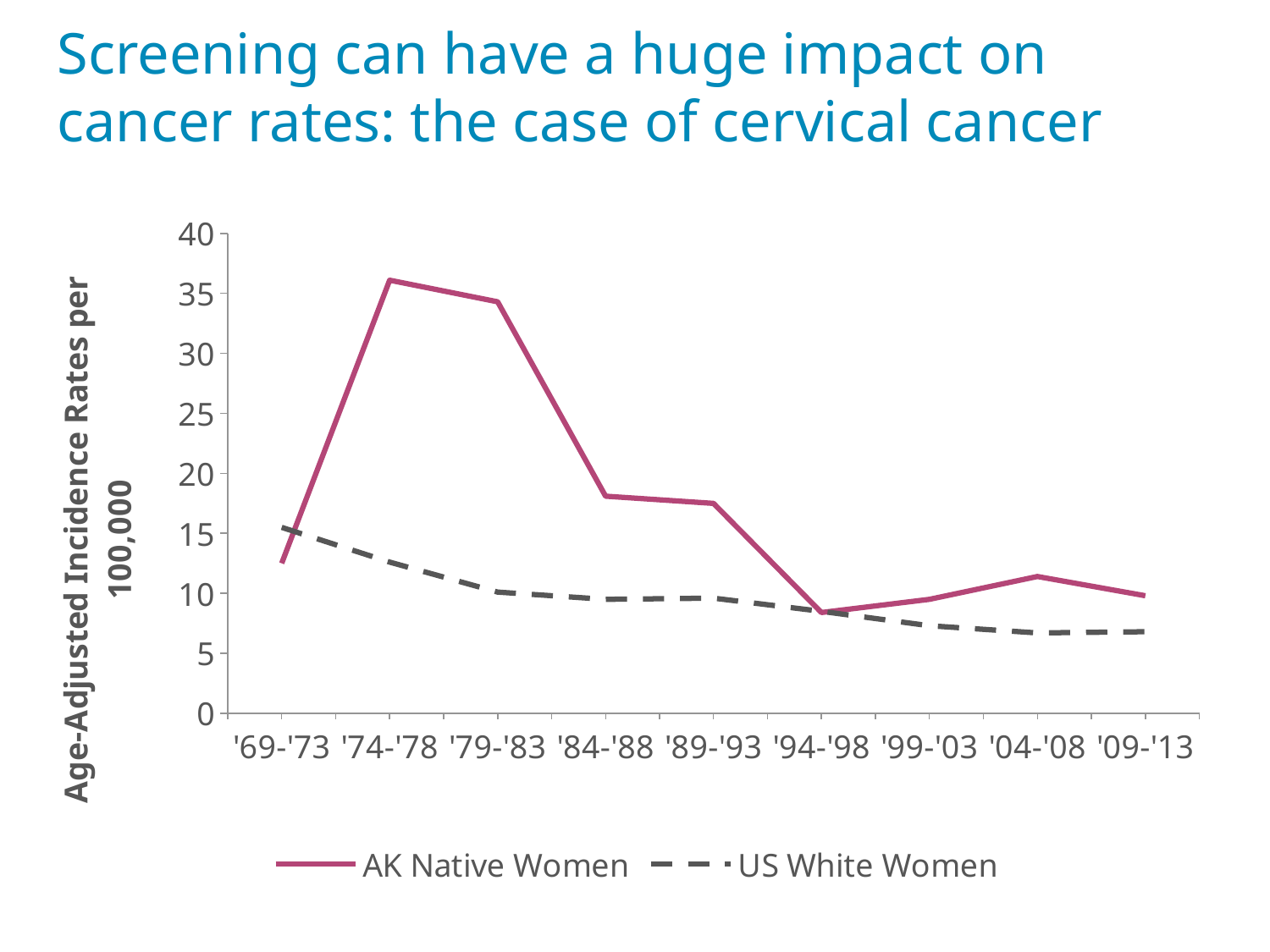
How many time periods are shown on the x axis? 9 What kind of chart is shown on the slide? line chart Is the AK Native Women value for '69-'73 greater or less than 15? less What is the label on the y axis? Age-Adjusted Incidence Rates per 100,000 Does the US White Women line generally rise or fall across the periods from '69-'73 to '09-'13? fall Is the US White Women value for '09-'13 greater or less than 10? less Is the AK Native Women value for '74-'78 greater or less than 30? greater Which series has the larger value in '69-'73, AK Native Women or US White Women? US White Women In which period is the US White Women rate highest? '69-'73 In which period is the AK Native Women rate highest? '74-'78 Which series has the larger value in '79-'83, AK Native Women or US White Women? AK Native Women How many series does the legend list? 2